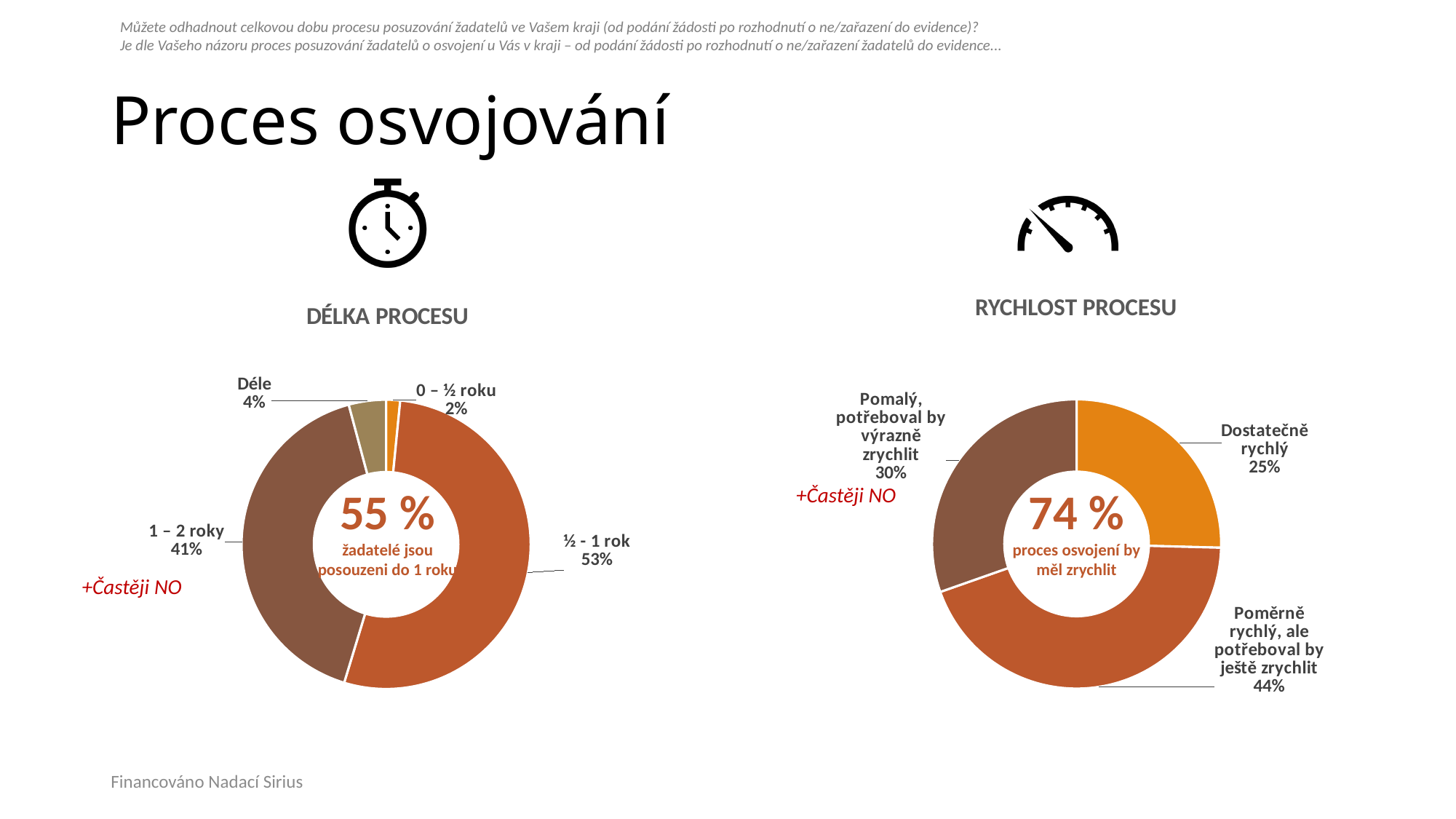
In the DÉLKA PROCESU chart, what is the difference between the shares for ½ - 1 rok and 1 – 2 roky? 12 percentage points In the RYCHLOST PROCESU chart, which category has the largest share? Poměrně rychlý, ale potřeboval by ještě zrychlit In the DÉLKA PROCESU chart, which category has the largest share? ½ - 1 rok What percentage is printed in the centre of the RYCHLOST PROCESU chart? 74 % In the DÉLKA PROCESU chart, what share of respondents answered ½ - 1 rok? 53% What type of chart is the RYCHLOST PROCESU chart? Doughnut (pie) chart In the RYCHLOST PROCESU chart, what share of respondents answered Dostatečně rychlý? 25% In the RYCHLOST PROCESU chart, which is larger: the share for Dostatečně rychlý or for Pomalý, potřeboval by výrazně zrychlit? Pomalý, potřeboval by výrazně zrychlit In the DÉLKA PROCESU chart, what share of respondents answered 1 – 2 roky? 41% In the DÉLKA PROCESU chart, how many categories are shown? 4 In the RYCHLOST PROCESU chart, what share of respondents answered Pomalý, potřeboval by výrazně zrychlit? 30% In the DÉLKA PROCESU chart, which category has the smallest share? 0 – ½ roku